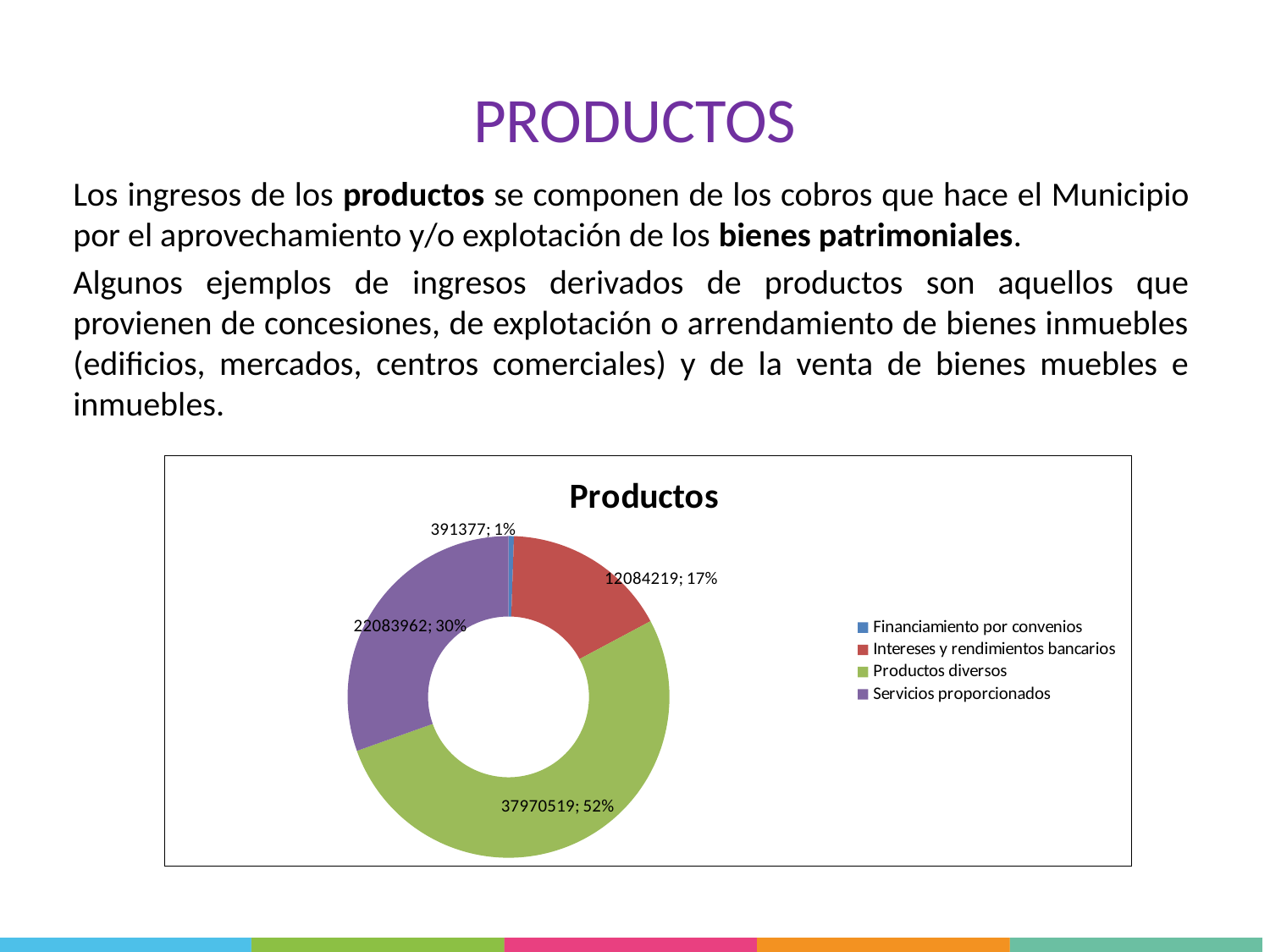
What value is shown for Servicios proporcionados? 22083962 What value is shown for Financiamiento por convenios? 391377 Which category has the smallest share of the chart? Financiamiento por convenios Which category has the largest share of the chart? Productos diversos What is the title of the chart? Productos What share of the chart does Servicios proporcionados represent? 30% What value is shown for Intereses y rendimientos bancarios? 12084219 Which is larger, the value for Servicios proporcionados or the value for Intereses y rendimientos bancarios? Servicios proporcionados What value is shown for Productos diversos? 37970519 What share of the chart does Productos diversos represent? 52% How many categories does the legend of the chart list? 4 What kind of chart is shown on the slide? Doughnut (pie) chart